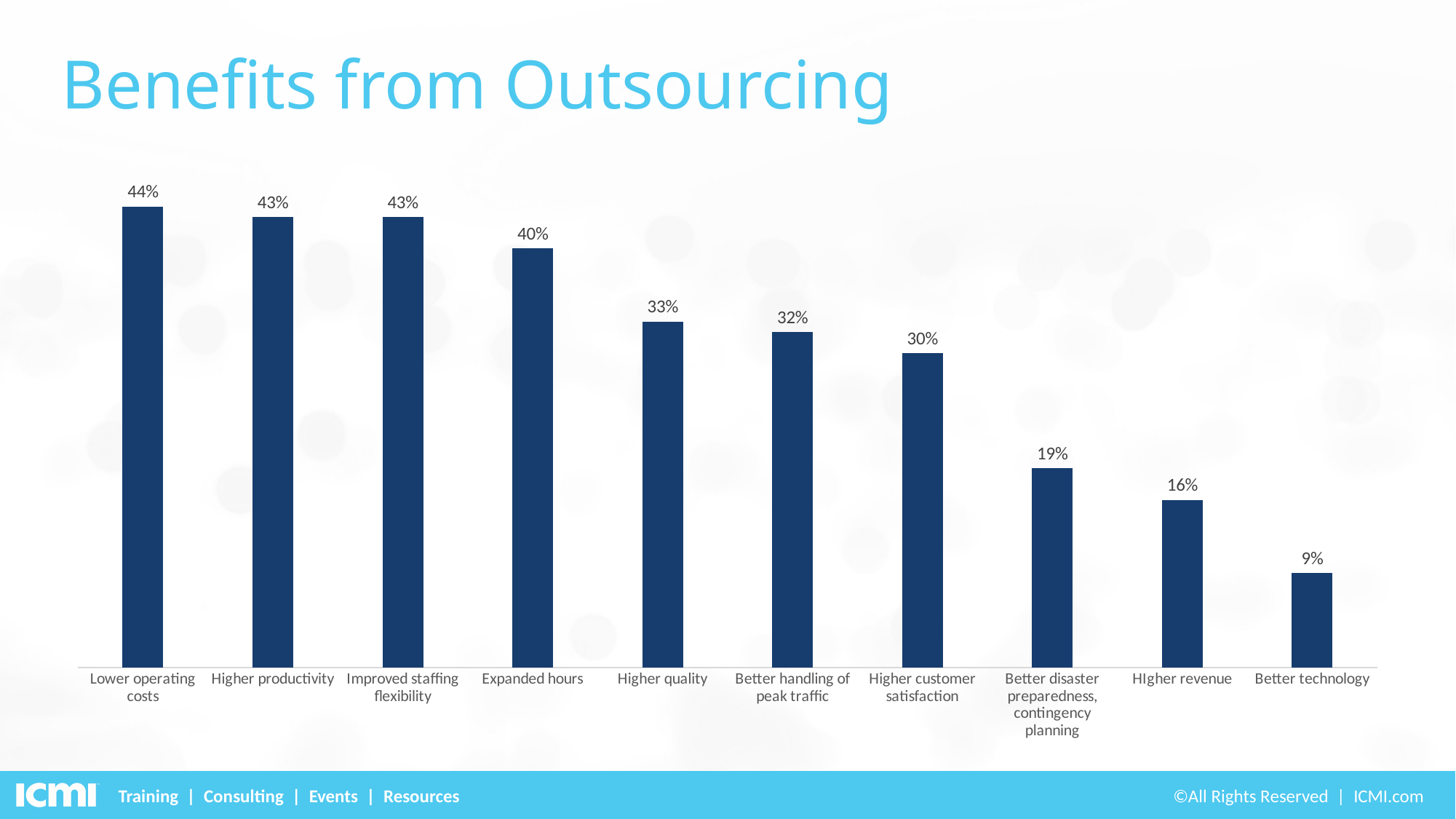
What is the difference between Lower operating costs and Better technology? 35% What is the value for Expanded hours? 40% Do the values rise or fall from left to right across the chart? Fall What kind of chart is shown on the slide? Bar chart What percentage is shown for Better handling of peak traffic? 32% Which is larger, Higher revenue or Better disaster preparedness, contingency planning? Better disaster preparedness, contingency planning What is the difference between Higher quality and Higher customer satisfaction? 3% Which benefit has the lowest percentage? Better technology Which benefit has the highest percentage? Lower operating costs What is the value for Better disaster preparedness, contingency planning? 19% What percentage is shown for Lower operating costs? 44% How many benefits are shown in the chart? 10